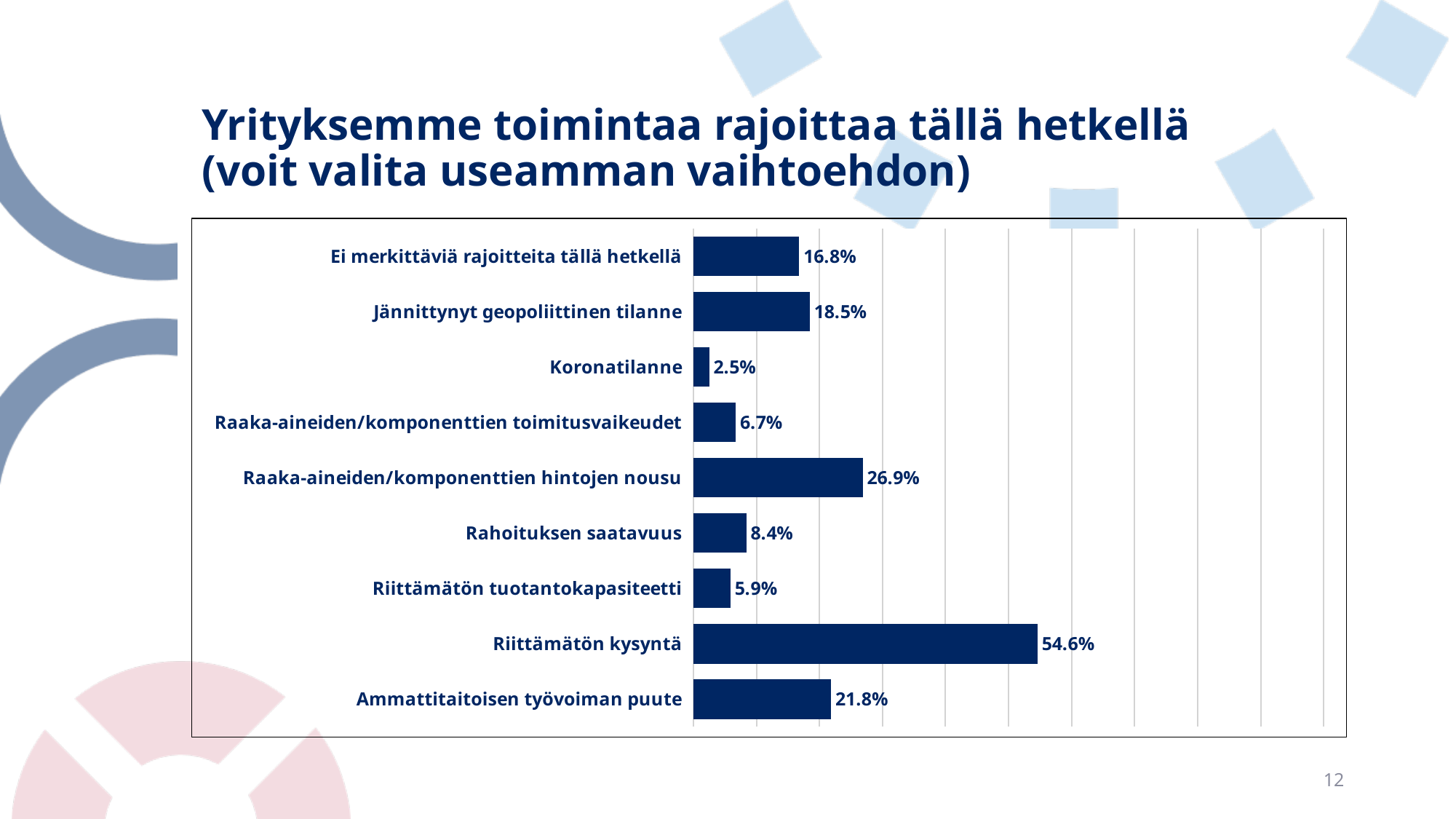
What is the value for Raaka-aineiden/komponenttien hintojen nousu? 26.9% What is the title of the slide? Yrityksemme toimintaa rajoittaa tällä hetkellä (voit valita useamman vaihtoehdon) How many categories are shown in the chart? 9 What is the difference between Jännittynyt geopoliittinen tilanne and Ei merkittäviä rajoitteita tällä hetkellä? 1.7% What is the value for Riittämätön kysyntä? 54.6% What is the value for Ammattitaitoisen työvoiman puute? 21.8% Which category has the lowest value? Koronatilanne What is the value for Koronatilanne? 2.5% Which category has the highest value? Riittämätön kysyntä What is the difference between Riittämätön kysyntä and Raaka-aineiden/komponenttien hintojen nousu? 27.7% Which is larger: Rahoituksen saatavuus or Riittämätön tuotantokapasiteetti? Rahoituksen saatavuus What kind of chart is shown on the slide? Bar chart